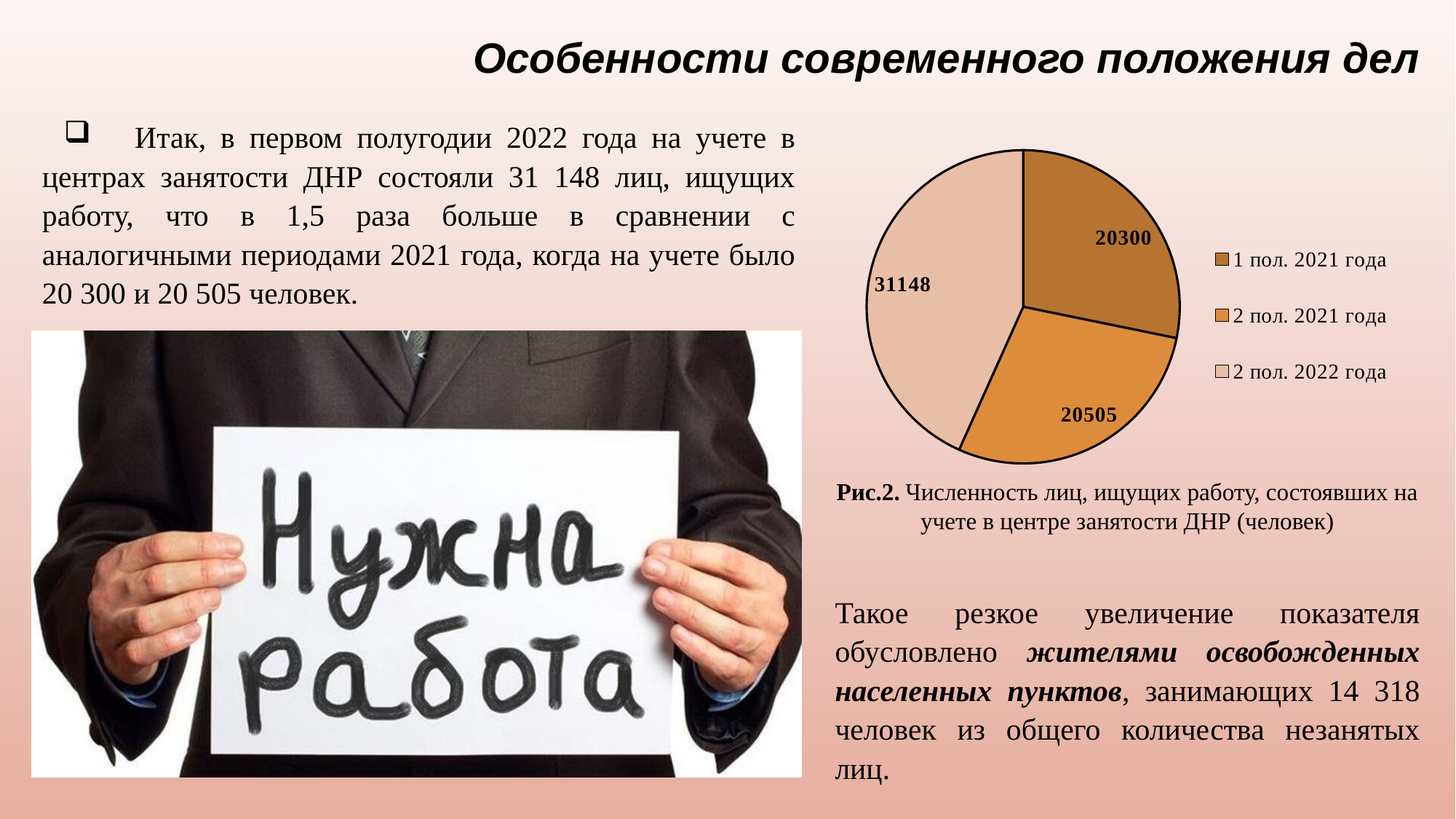
What is the difference between the values for 2 пол. 2022 года and 1 пол. 2021 года? 10848 What is the value for 1 пол. 2021 года in the pie chart? 20300 What is the value for 2 пол. 2022 года in the pie chart? 31148 What is the value for 2 пол. 2021 года in the pie chart? 20505 Which is larger: the value for 2 пол. 2021 года or 1 пол. 2021 года? 2 пол. 2021 года How many entries does the legend of the pie chart list? 3 What type of chart is shown on the slide? pie chart Which period has the smallest slice in the pie chart? 1 пол. 2021 года How many slices does the pie chart have? 3 Which period has the largest slice in the pie chart? 2 пол. 2022 года What is the figure number given in the caption of the pie chart? Рис.2. What is the difference between the values for 2 пол. 2021 года and 1 пол. 2021 года? 205